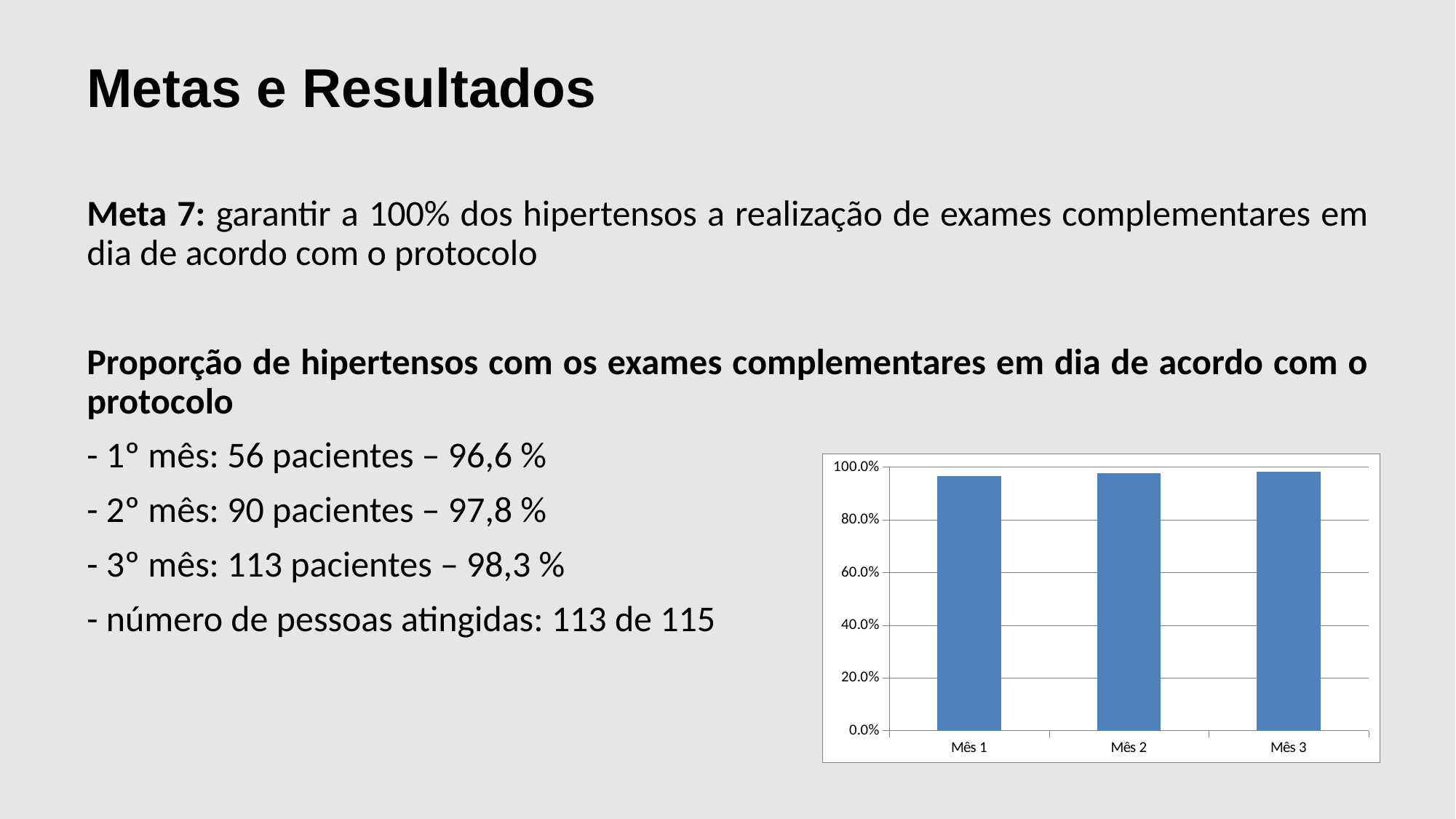
Is the value for Mês 2 greater or less than 80.0%? greater What kind of chart is shown on the slide? bar chart What is the highest tick value shown on the y axis of the chart? 100.0% Is the value for Mês 1 greater or less than 80.0%? greater What is the label of the first category on the x axis of the chart? Mês 1 Is the value for Mês 1 greater or less than 100.0%? less How many categories are plotted on the x axis of the chart? 3